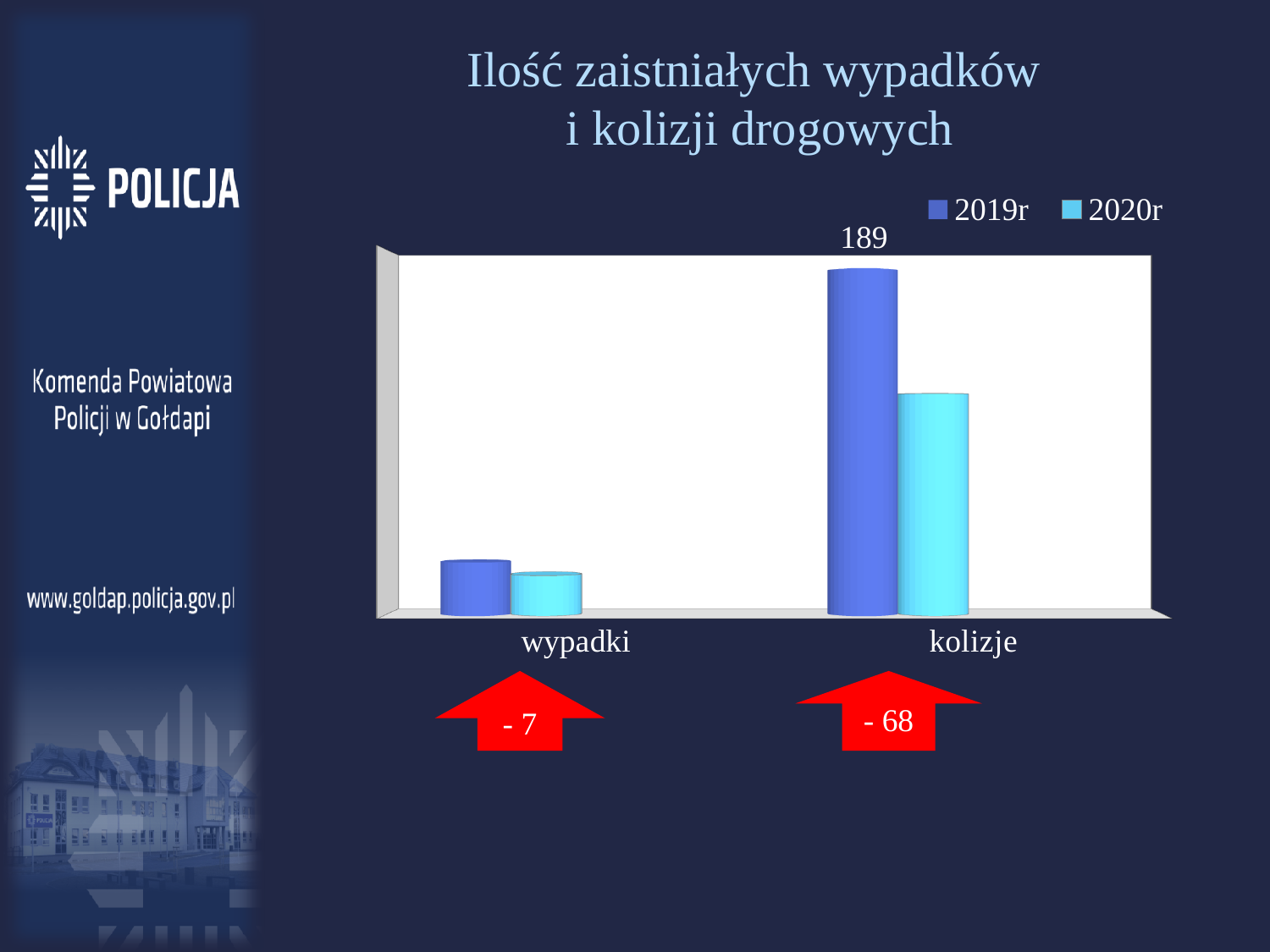
What is the value for kolizje in the 2019r series? 189 Which category has the lowest value in the 2020r series? wypadki How many series does the legend list? 2 For kolizje, which series has the larger value, 2019r or 2020r? 2019r What kind of chart is shown on the slide? bar chart How many categories are shown on the x axis? 2 What are the two series listed in the legend? 2019r and 2020r Which category has the highest value in the 2019r series? kolizje For wypadki, which series has the larger value, 2019r or 2020r? 2019r In the 2020r series, which category has the larger value, wypadki or kolizje? kolizje What is the title of the chart? Ilość zaistniałych wypadków i kolizji drogowych